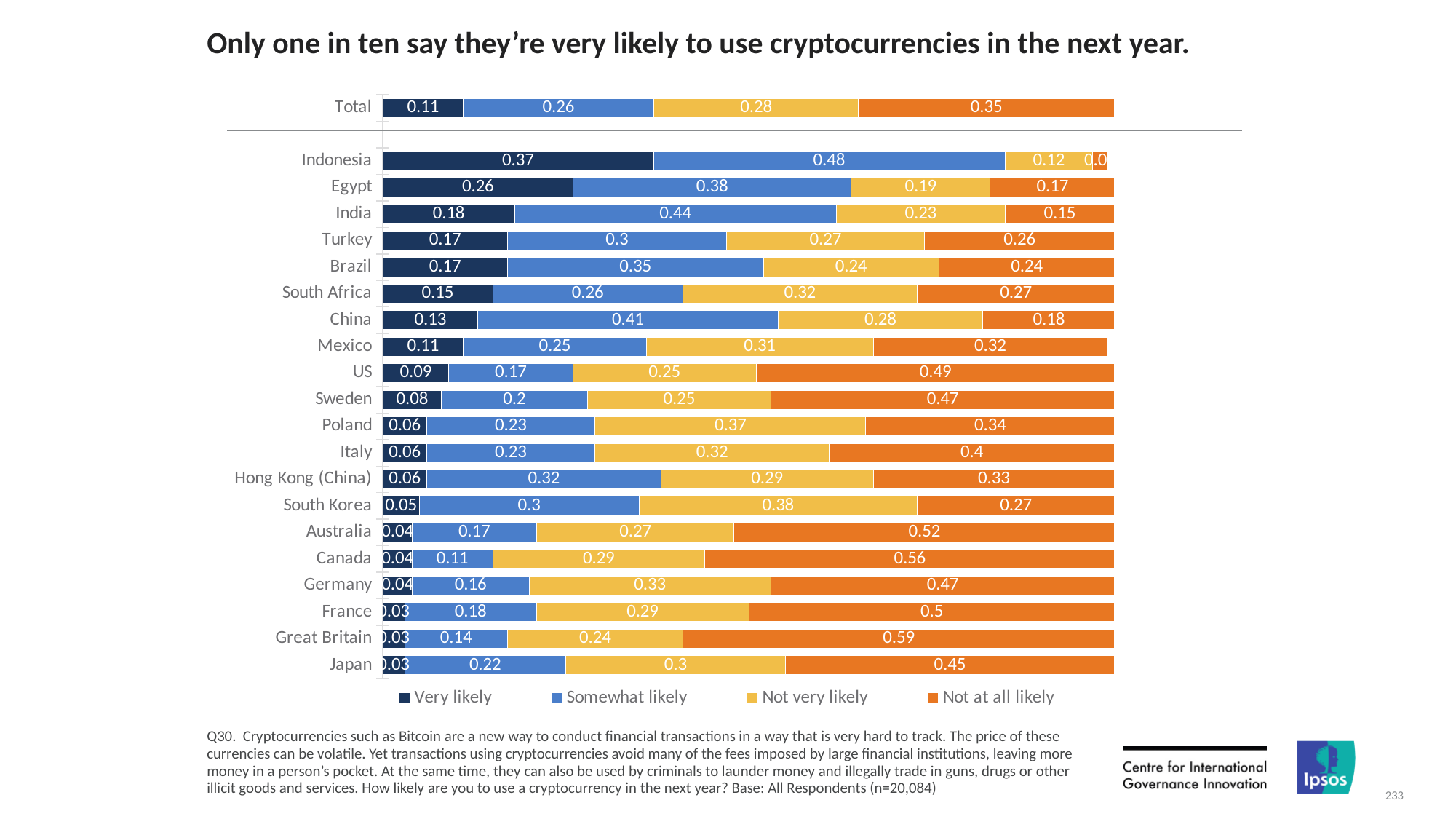
Which legend entry is shown in dark navy blue? Very likely Which country has the highest 'Not at all likely' value? Great Britain What is the difference between the 'Very likely' values for Egypt and India? 0.08 How many countries (excluding the Total row) are shown in the chart? 20 What kind of chart is shown on the slide? Stacked bar chart What is the 'Not at all likely' value for Canada? 0.56 Which country has the highest 'Very likely' value? Indonesia How many series does the legend list? 4 What is the 'Somewhat likely' value for China? 0.41 What is the 'Very likely' value for Indonesia? 0.37 Which is larger: the 'Not at all likely' value for the US or for Sweden? US What is the 'Not very likely' value for South Korea? 0.38